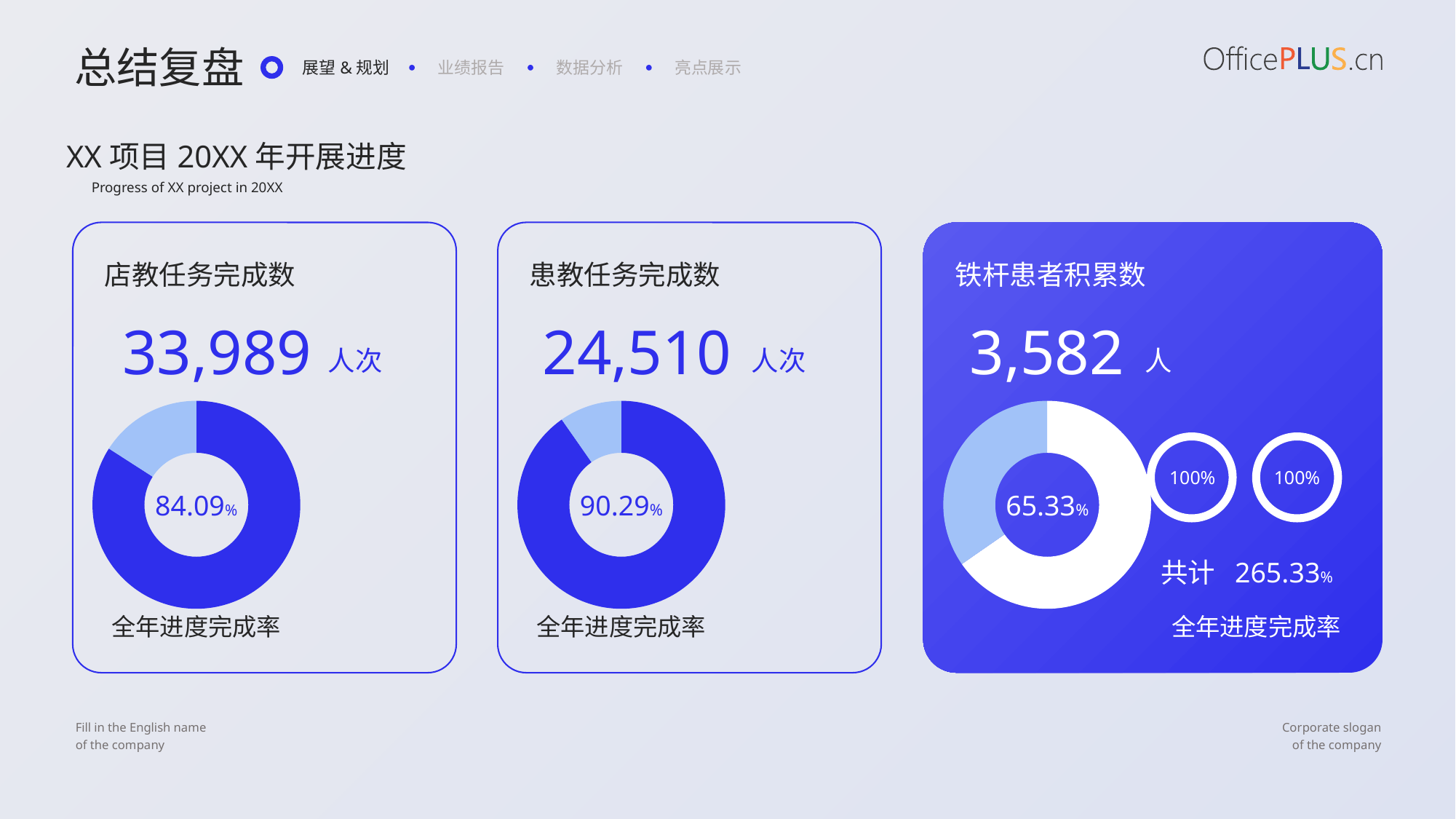
Is the completion rate in the 店教任务完成数 donut chart larger or smaller than the one in the 铁杆患者积累数 donut chart? Larger In the 铁杆患者积累数 card, what value is shown in each of the two small circles to the right of the large donut? 100% What type of chart is used in the 店教任务完成数 card? Donut chart In the 铁杆患者积累数 card, what completion rate is shown in the centre of the large donut chart? 65.33% What is the difference between the completion rate in the 患教任务完成数 donut chart and the 店教任务完成数 donut chart? 6.20% In the 患教任务完成数 card, what completion rate is shown in the centre of the donut chart? 90.29% In the 店教任务完成数 card, what completion rate is shown in the centre of the donut chart? 84.09% Which card's donut chart shows the lowest 全年进度完成率: 店教任务完成数, 患教任务完成数, or 铁杆患者积累数? 铁杆患者积累数 How many donut charts are shown on the slide in total, including the two small circles? 5 In the 铁杆患者积累数 card, what is the 共计 (total) percentage shown? 265.33% Which card's donut chart shows the highest 全年进度完成率: 店教任务完成数, 患教任务完成数, or 铁杆患者积累数? 患教任务完成数 What label appears below the donut chart in the 店教任务完成数 card? 全年进度完成率